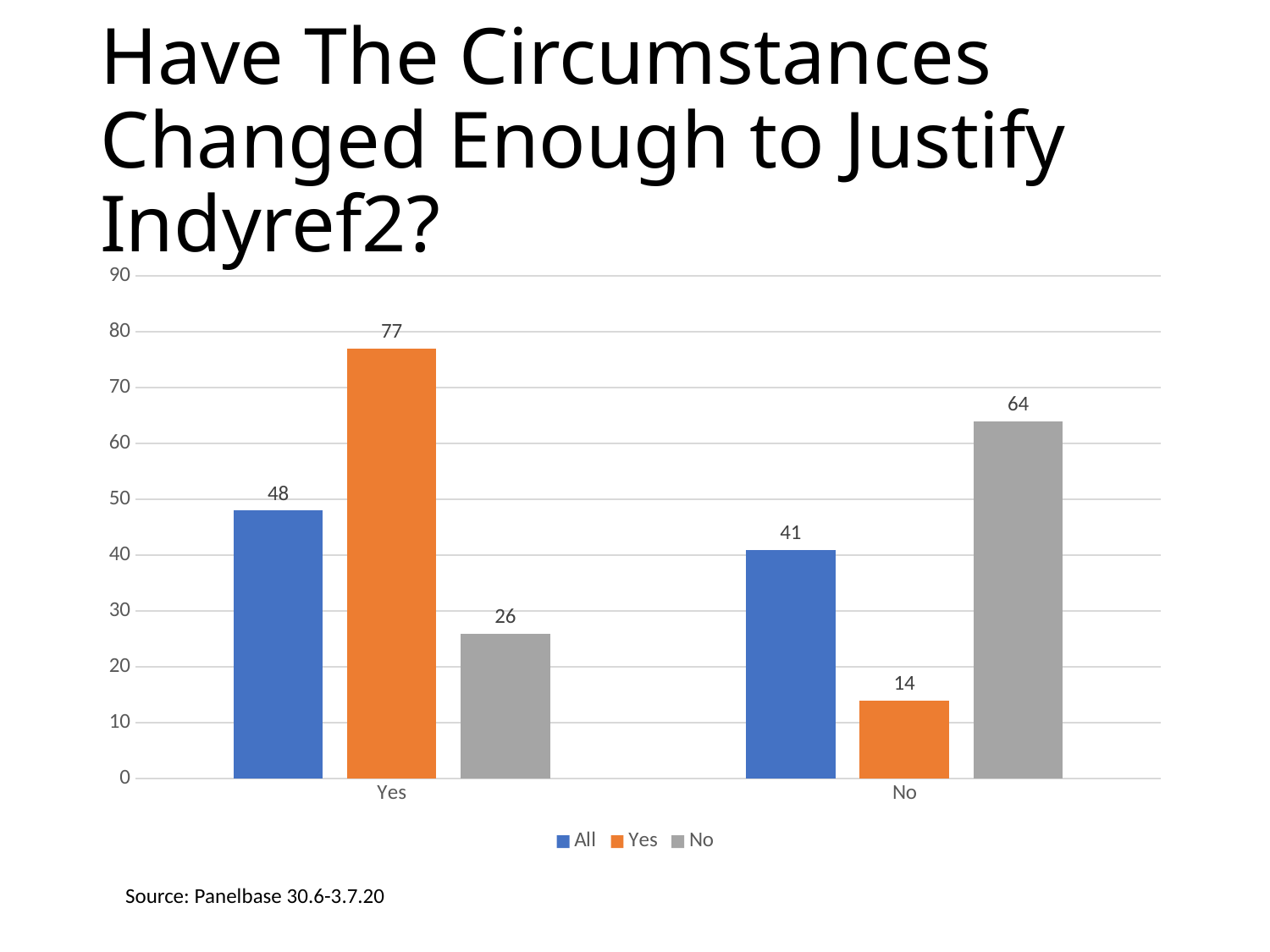
What kind of chart is shown on the slide? Bar chart What is the difference between the All values for the Yes and No categories? 7 What is the value for the No series in the No category? 64 Which series has the lowest value in the No category? Yes What is the difference between the No series values in the No and Yes categories? 38 What is the value for the Yes series in the No category? 14 What is the value for the All series in the Yes category? 48 Which is larger: the All value in the Yes category or the All value in the No category? Yes Which series has the highest value in the Yes category? Yes How many series does the legend list? 3 What source is cited below the chart? Panelbase 30.6-3.7.20 What is the value for the Yes series in the Yes category? 77